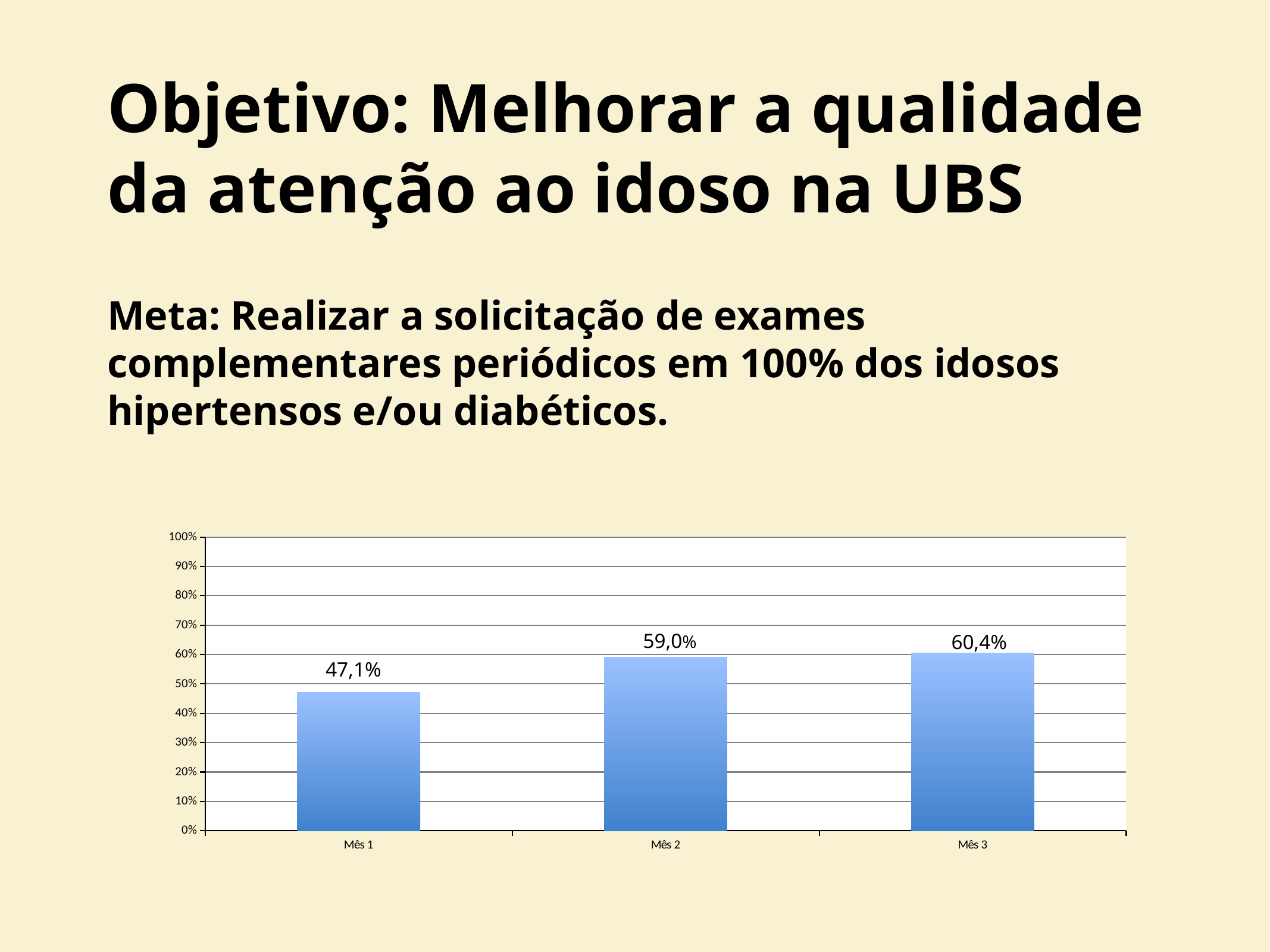
What is the difference between the values for Mês 3 and Mês 1? 13,3% Which month has the lowest value? Mês 1 What is the value for Mês 3? 60,4% Which month has the highest value? Mês 3 Is the value for Mês 1 greater or less than 50%? less What is the value for Mês 1? 47,1% How many months are shown on the x axis? 3 Which is larger, the value for Mês 1 or the value for Mês 2? Mês 2 What kind of chart is shown on the slide? bar chart What is the difference between the values for Mês 2 and Mês 1? 11,9% Do the values rise or fall from Mês 1 to Mês 3? rise What is the value for Mês 2? 59,0%